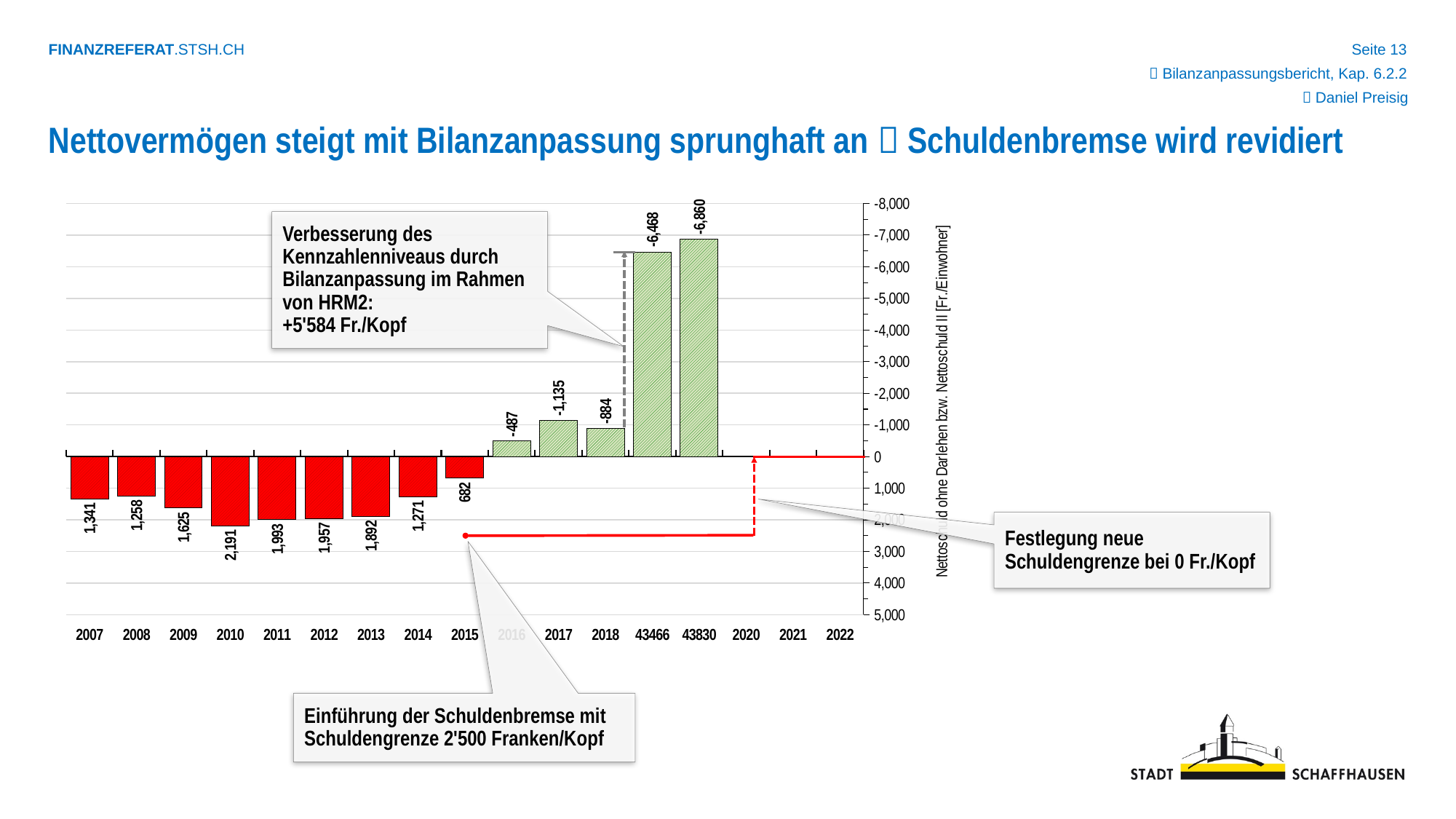
Which is larger, the value for 2009 or the value for 2013? 2013 What is the value shown for 2010? 2,191 What is the difference between the values for 2007 and 2008? 83 Which year has the smallest red (positive) bar? 2015 What is the value shown for 2015? 682 What debt limit (Schuldengrenze) is mentioned in the callout about the introduction of the Schuldenbremse? 2'500 Franken/Kopf Do the red bar values rise or fall from 2010 to 2015? fall What is the value shown for 2018? -884 Which year has the largest red (positive) bar? 2010 What kind of chart is shown on the slide? bar chart What is the difference between the values for 2010 and 2011? 198 What is the value shown for 2017? -1,135